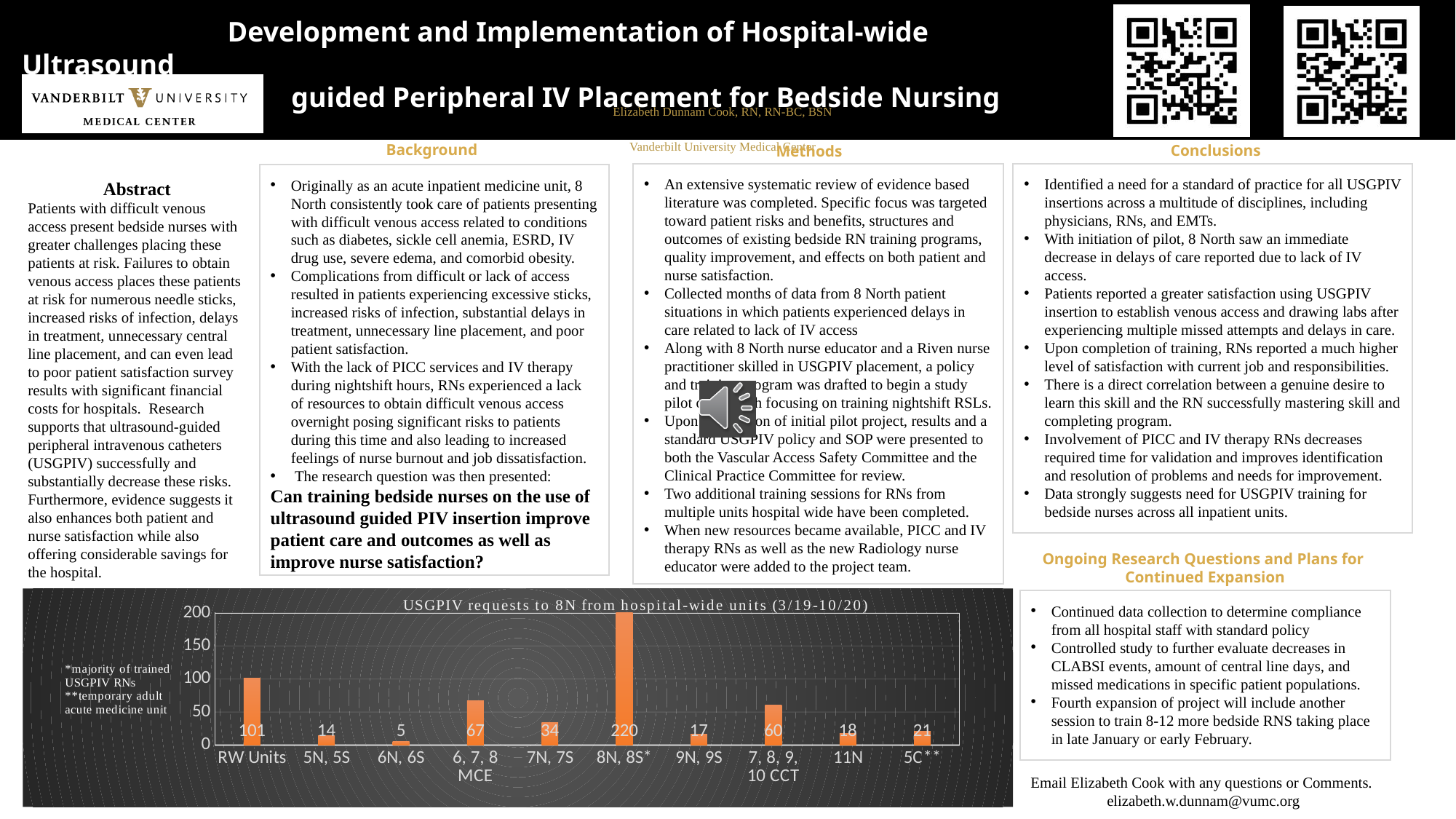
Which unit has the highest number of USGPIV requests? 8N, 8S* What is the difference between the values for 8N, 8S* and RW Units? 119 Is the value for 6, 7, 8 MCE greater or less than 50? greater What is the value for RW Units in the chart? 101 How many units (categories) are shown on the x axis of the chart? 10 What is the value for 7, 8, 9, 10 CCT in the chart? 60 What is the value for 8N, 8S* in the chart? 220 Which unit has the lowest number of USGPIV requests? 6N, 6S What kind of chart is shown on the slide? Bar chart Which is larger, the value for 11N or the value for 5C**? 5C** What is the difference between the values for 6, 7, 8 MCE and 7N, 7S? 33 What is the title of the chart? USGPIV requests to 8N from hospital-wide units (3/19-10/20)